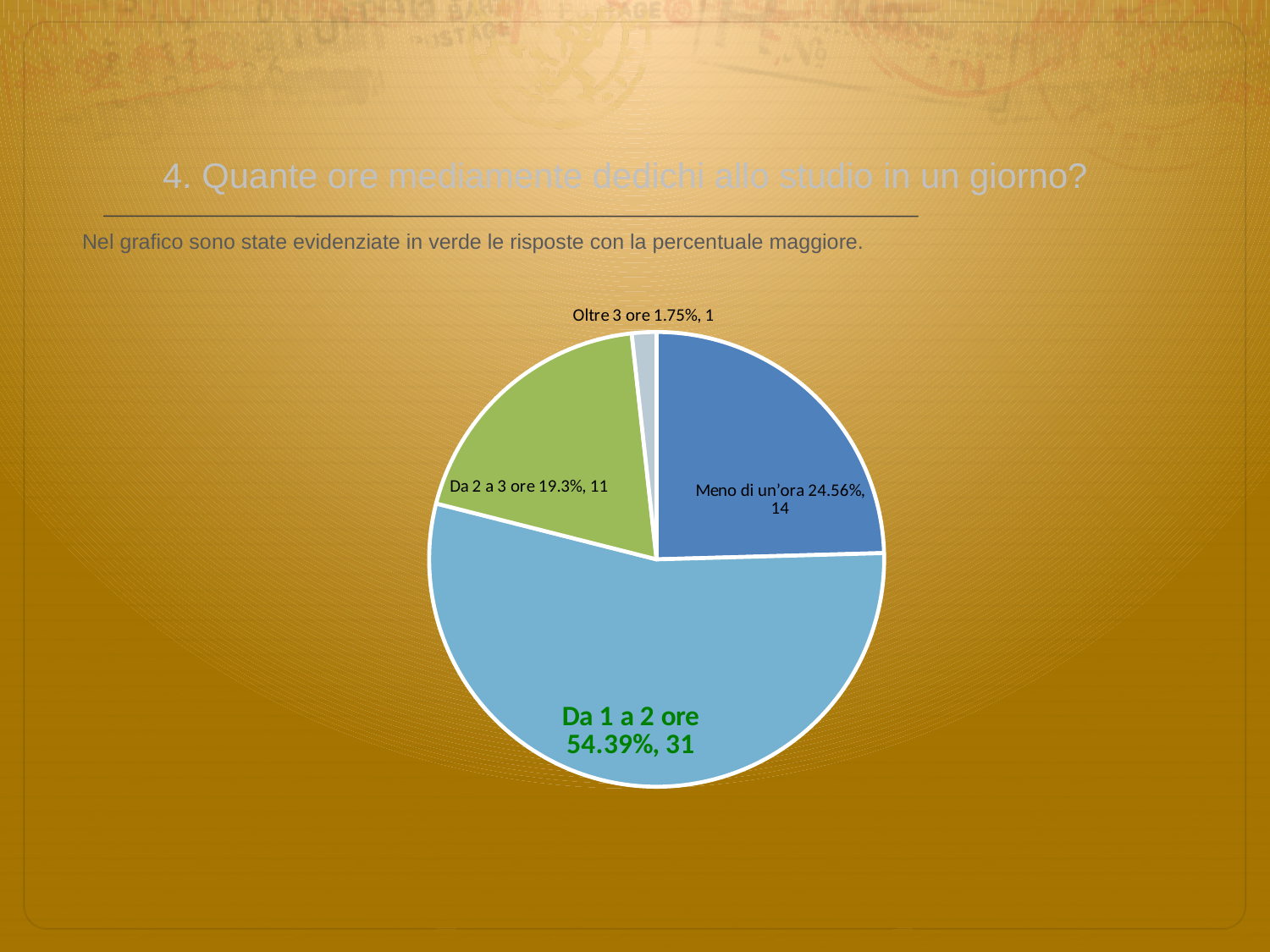
What kind of chart is shown on the slide? pie chart What is the total number of responses across all slices? 57 What percentage of responses is 'Da 1 a 2 ore'? 54.39% What percentage is shown for 'Da 2 a 3 ore'? 19.3% How many slices does the pie chart have? 4 What is the difference in number of responses between 'Da 1 a 2 ore' and 'Meno di un'ora'? 17 Which category has the smallest share of the pie? Oltre 3 ore How many responses are in the 'Oltre 3 ore' slice? 1 Which slice's label is highlighted in green? Da 1 a 2 ore Which category has the largest share of the pie? Da 1 a 2 ore Which has more responses, 'Meno di un'ora' or 'Da 2 a 3 ore'? Meno di un'ora How many responses are in the 'Meno di un'ora' slice? 14